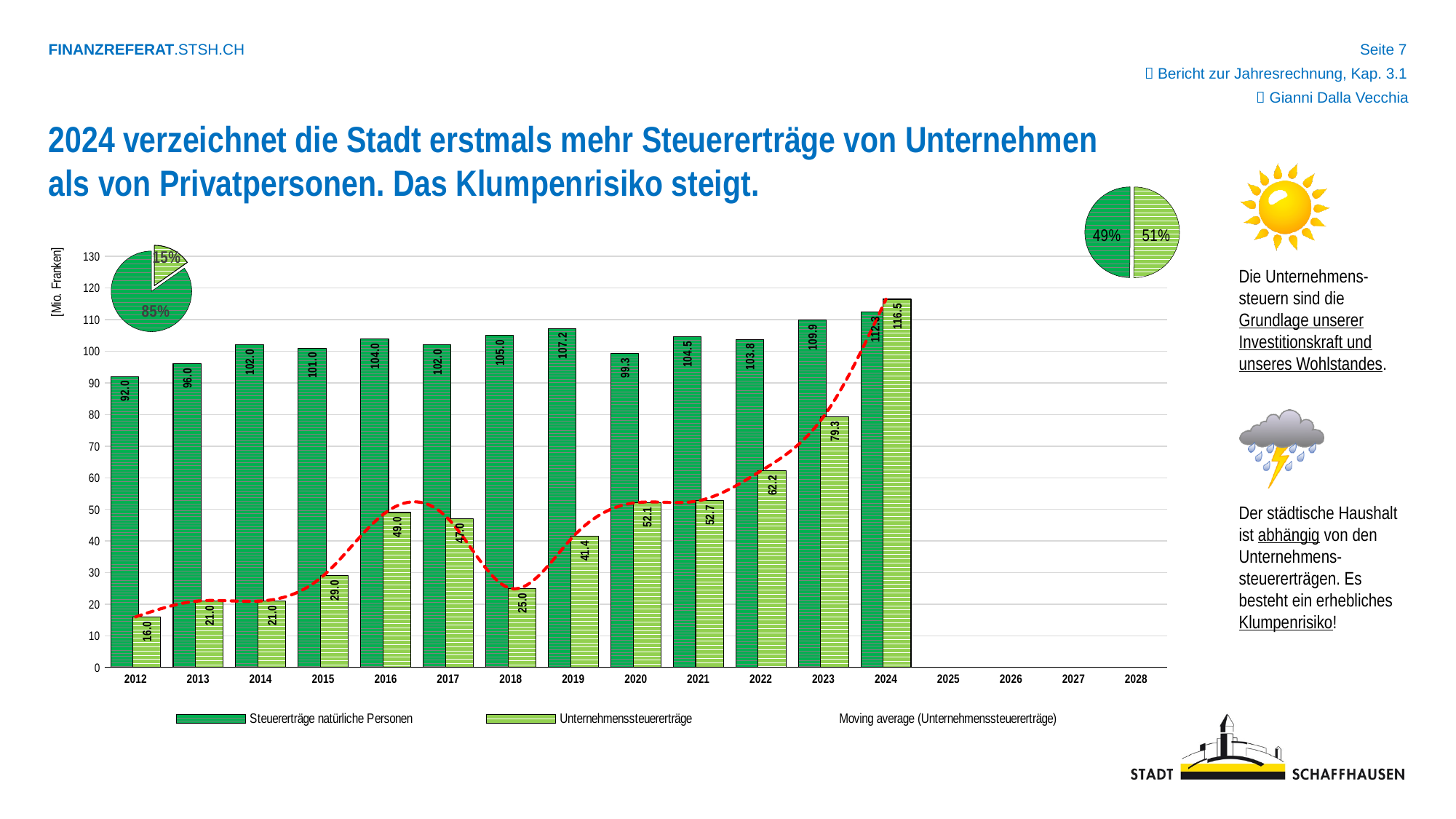
In the bar chart, which is larger in 2024: Steuererträge natürliche Personen or Unternehmenssteuererträge? Unternehmenssteuererträge In the bar chart, do the Unternehmenssteuererträge values rise or fall from 2020 to 2024? rise What kind of chart is the main chart on the slide? combination bar and line chart In the small pie chart at the top right of the chart area, what share does the larger slice show? 51% In the bar chart, which year has the lowest value for Unternehmenssteuererträge? 2012 In the bar chart, is the value of Unternehmenssteuererträge for 2018 greater or less than 30? less In the bar chart, what is the value of Steuererträge natürliche Personen for 2019? 107.2 How many entries does the legend of the bar chart list? 3 In the bar chart, what is the difference between Unternehmenssteuererträge in 2024 and in 2023? 37.2 In the bar chart, what is the value of Unternehmenssteuererträge for 2024? 116.5 How many years have bars plotted in the bar chart? 13 In the bar chart, which year has the highest value for Steuererträge natürliche Personen? 2024